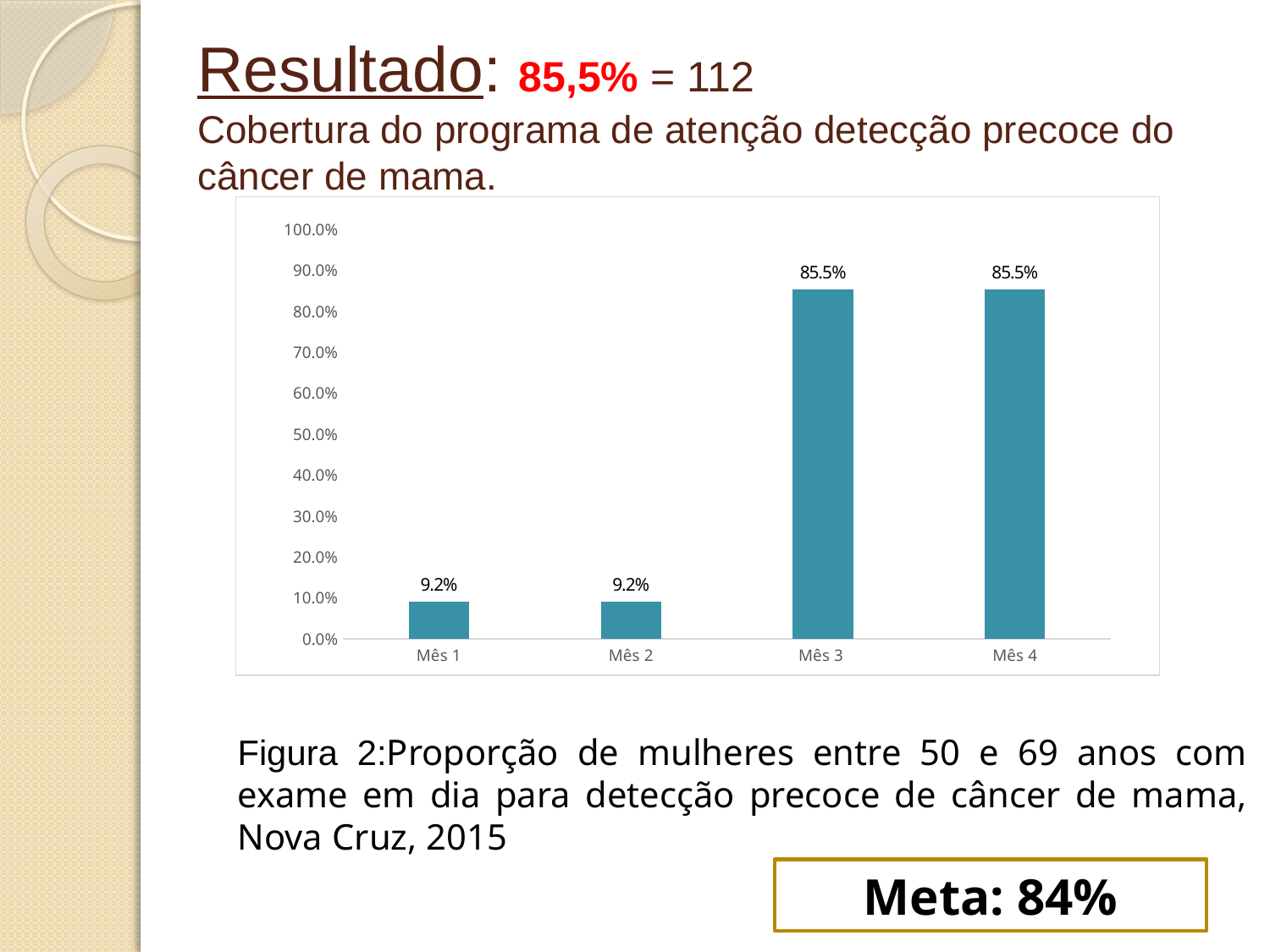
How many categories are shown on the x axis? 4 Is the value for Mês 3 greater or less than 80.0%? greater What is the value for Mês 1? 9.2% Do the values rise or fall from Mês 2 to Mês 3? rise What is the highest value shown on the y axis? 100.0% What is the value for Mês 3? 85.5% What kind of chart is shown on the slide? bar chart What is the difference between the values for Mês 3 and Mês 1? 76.3% Which is larger, the value for Mês 2 or the value for Mês 4? Mês 4 What is the value for Mês 2? 9.2% Is the value for Mês 1 greater or less than 10.0%? less What is the value for Mês 4? 85.5%